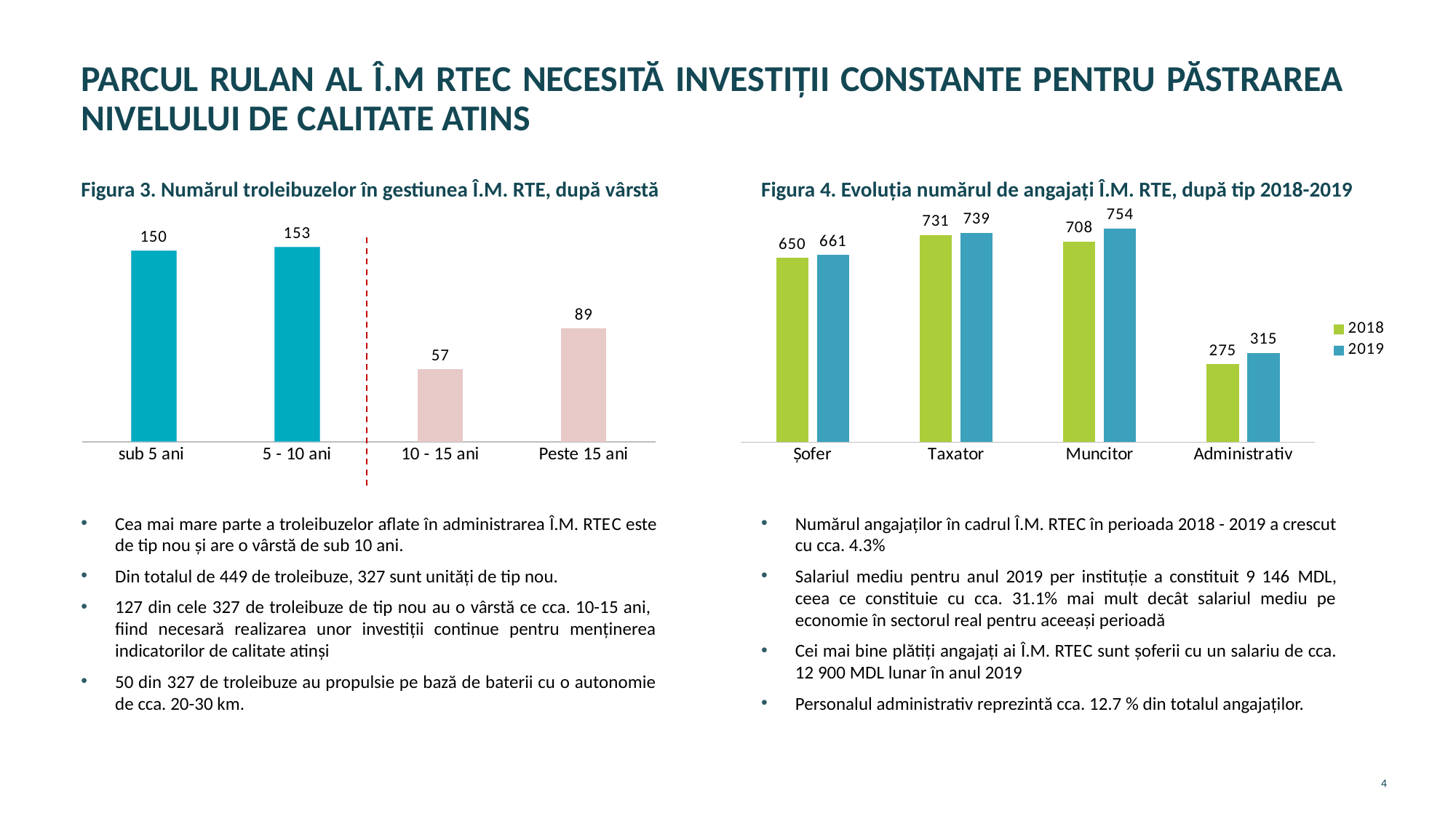
In Figura 4, what is the difference between the 2019 and 2018 values for 'Muncitor'? 46 In Figura 4, which employee type had the highest value in 2019? Muncitor In Figura 3, how many age categories are shown? 4 In Figura 4, is the 2018 value for 'Șofer' larger or smaller than the 2018 value for 'Taxator'? Smaller In Figura 3, which age category has the highest number of trolleybuses? 5 - 10 ani In Figura 3, which age category has the lowest number of trolleybuses? 10 - 15 ani What type of chart is Figura 3? Bar chart In Figura 4, how many series does the legend list? 2 In Figura 3, what is the difference between the '5 - 10 ani' and 'Peste 15 ani' values? 64 In Figura 3, how many trolleybuses are in the 'sub 5 ani' category? 150 In Figura 4, what was the number of 'Taxator' employees in 2019? 739 In Figura 4, what was the number of 'Administrativ' employees in 2018? 275